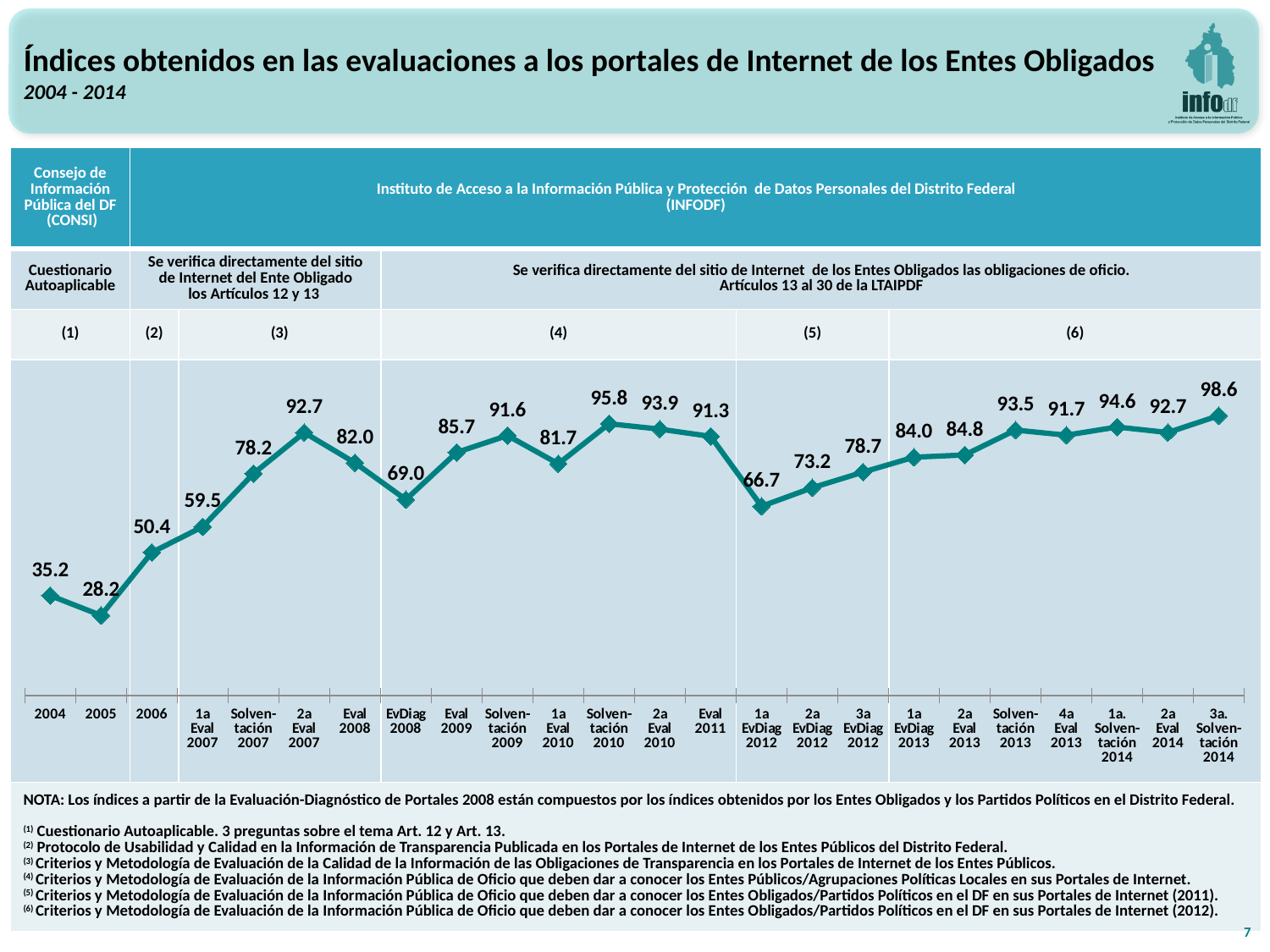
What is the index value for Solventación 2010? 95.8 What is the index value for 3a Solventación 2014? 98.6 What is the index value for 1a EvDiag 2012? 66.7 Which evaluation has the highest index value? 3a Solventación 2014 What is the difference between the index for 2a Eval 2007 and the index for 1a Eval 2007? 33.2 How many data points are plotted on the chart? 24 Which evaluation has the lowest index value? 2005 Do the index values rise or fall from 1a EvDiag 2012 to 3a EvDiag 2012? Rise What is the difference between the index for 3a Solventación 2014 and the index for 2004? 63.4 What kind of chart is shown on the slide? Line chart What is the index value for 2004? 35.2 Which is larger, the index for Eval 2009 or the index for 1a Eval 2010? Eval 2009